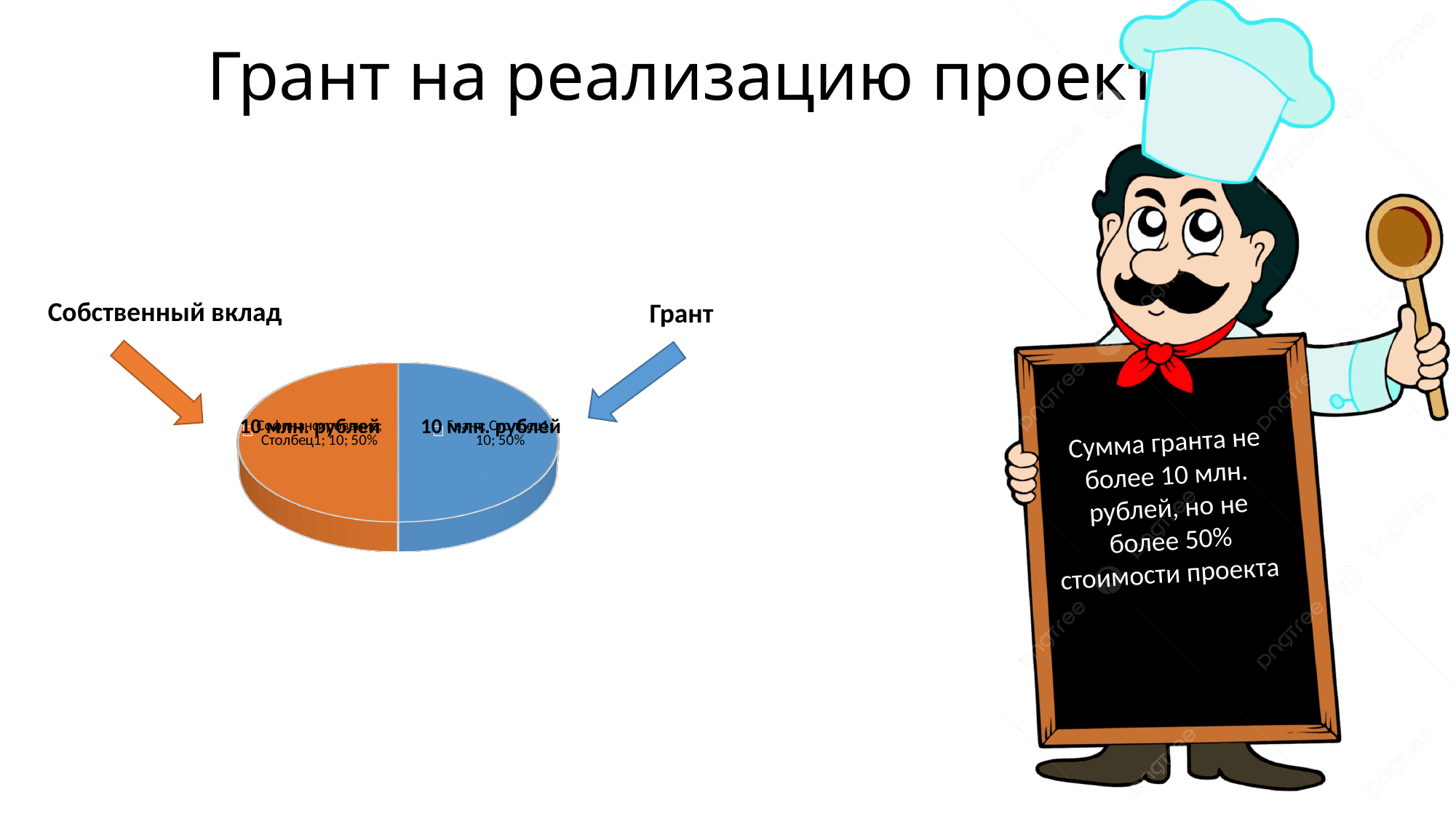
What colour is the Грант slice of the pie chart? blue What value is labelled on the Собственный вклад slice of the pie chart? 10 млн. рублей How many slices does the pie chart have? 2 What colour is the Собственный вклад slice of the pie chart? orange What value is labelled on the Грант slice of the pie chart? 10 млн. рублей What kind of chart is shown on the slide? pie chart Is the share of the Грант slice greater or less than 25%? greater What share of the pie does the Грант slice represent? 50% What share of the pie does the Собственный вклад slice represent? 50%